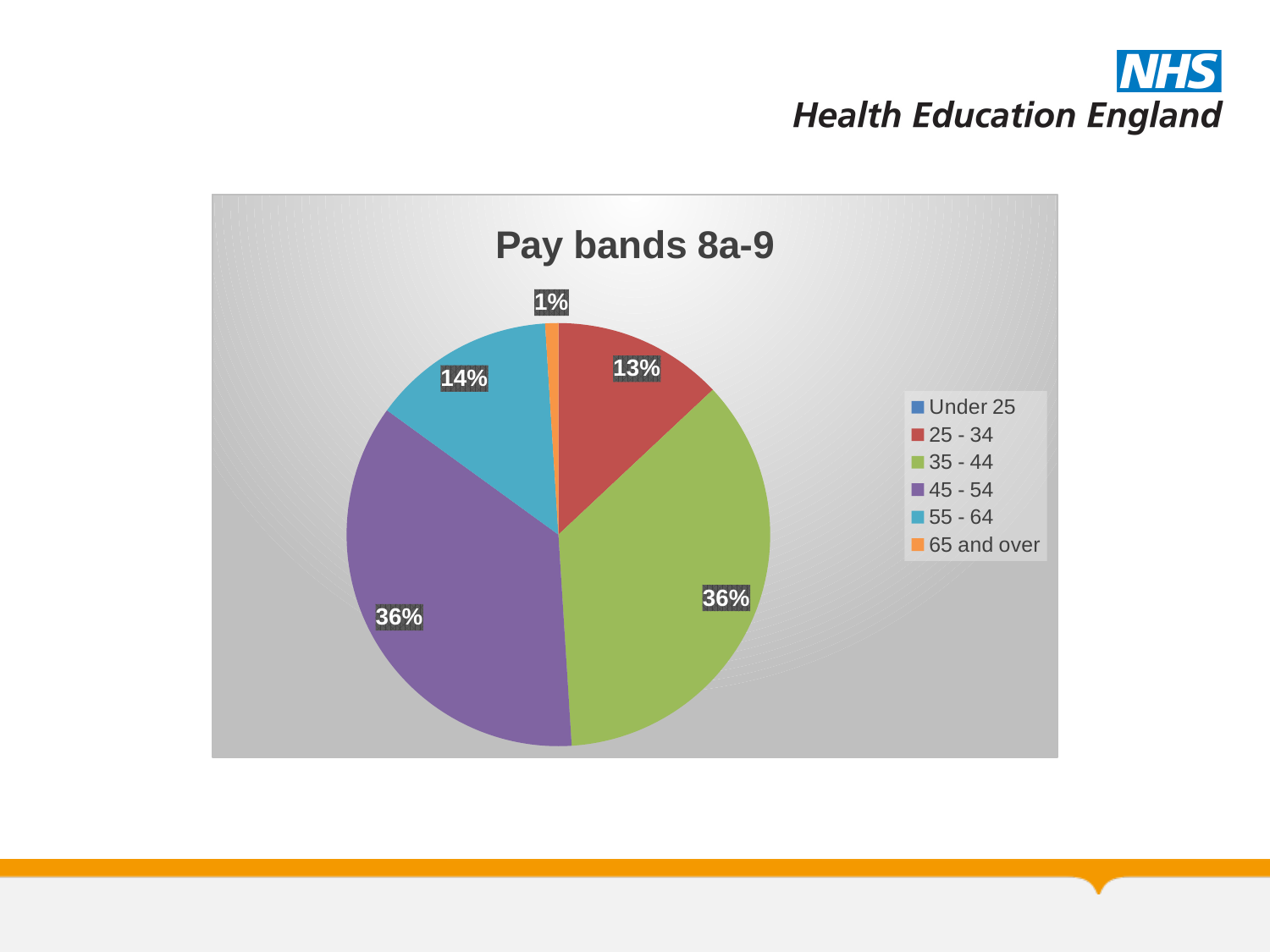
Which slice is smaller, 55 - 64 or 65 and over? 65 and over What percentage of the pie is the 25 - 34 slice? 13% What percentage of the pie is the 45 - 54 slice? 36% How many categories does the legend list? 6 What colour is the 45 - 54 slice? purple What is the difference in percentage points between the 45 - 54 slice and the 25 - 34 slice? 23 What is the title of the chart? Pay bands 8a-9 What percentage of the pie is the 65 and over slice? 1% What percentage of the pie is the 35 - 44 slice? 36% What type of chart is shown on the slide? pie chart Which slice is larger, 25 - 34 or 55 - 64? 55 - 64 What percentage of the pie is the 55 - 64 slice? 14%